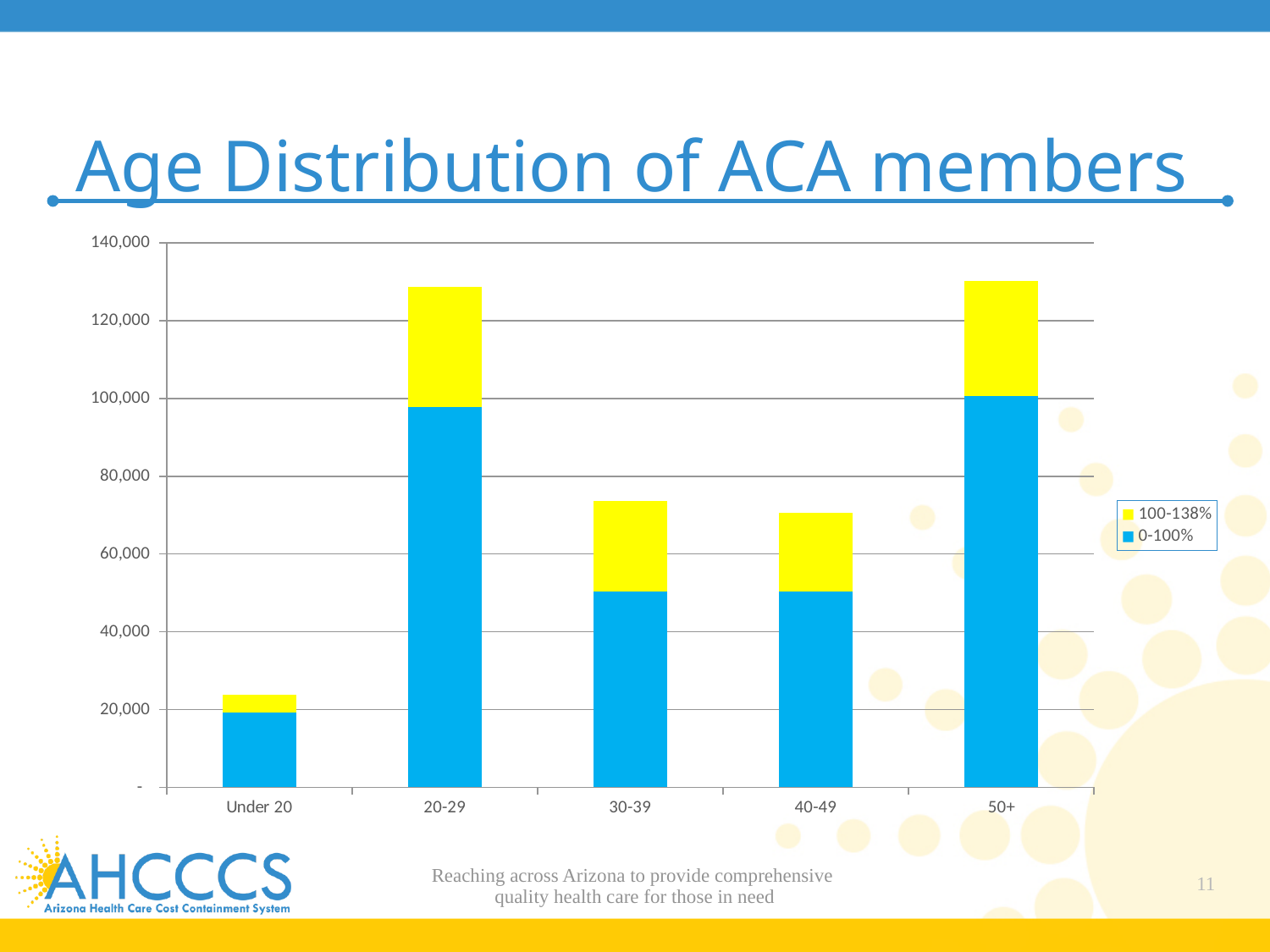
What kind of chart is shown on the slide? Stacked bar chart Is the 0-100% value for the 50+ bar greater or less than 80,000? greater Which is larger, the total for 20-29 or the total for 30-39? 20-29 Is the 0-100% value for the 40-49 bar greater or less than 60,000? less Is the total value for the 30-39 bar greater or less than 80,000? less Which series is shown in yellow? 100-138% Which age category has the lowest total number of members? Under 20 What is the title of the chart? Age Distribution of ACA members How many series does the legend list? 2 How many age categories are shown on the x axis? 5